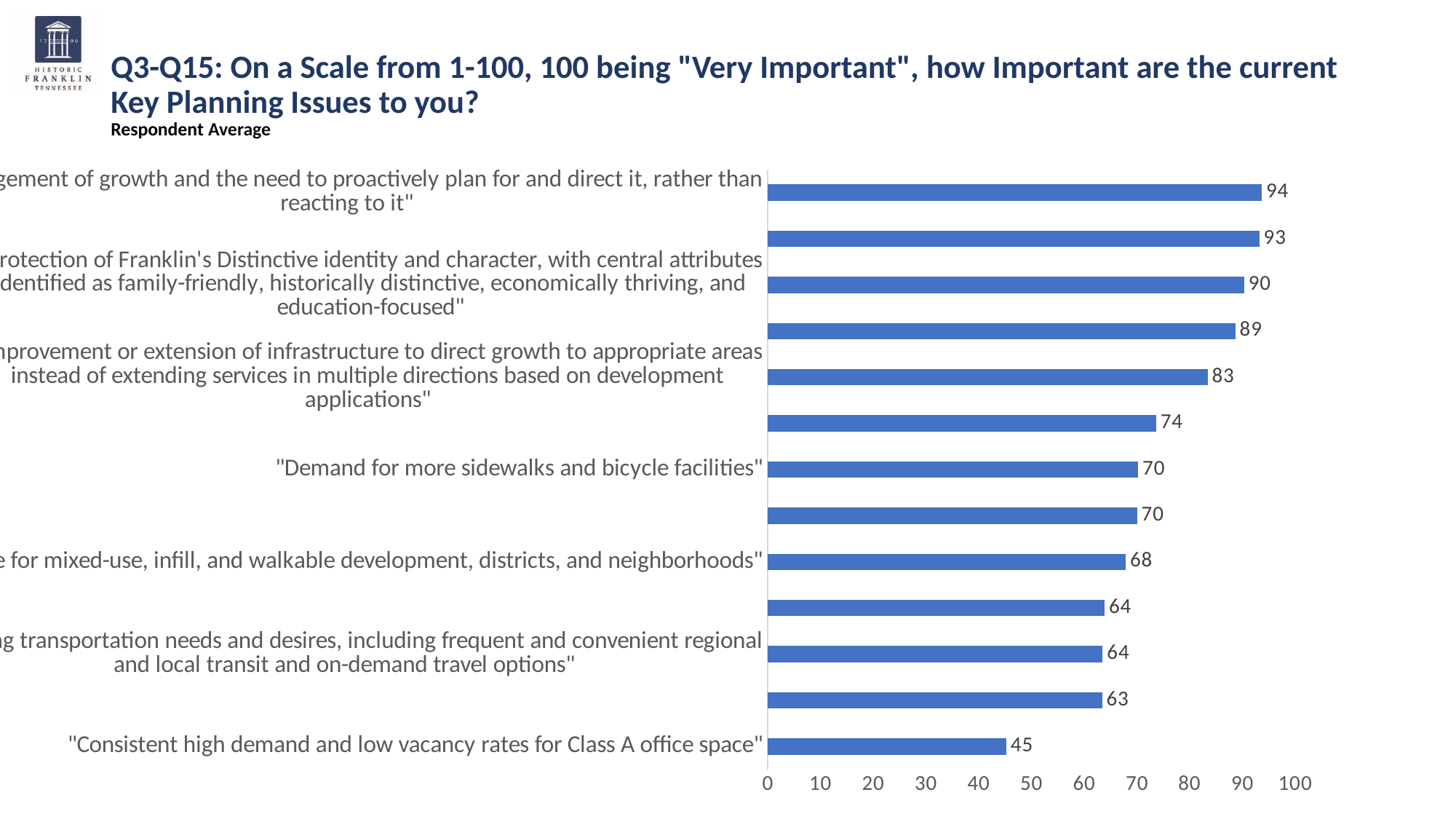
What is the respondent average for "Consistent high demand and low vacancy rates for Class A office space"? 45 What is the lowest value shown on the chart? 45 How many bars are plotted on the chart? 13 What is the highest value shown on the chart? 94 What is the respondent average for "Demand for more sidewalks and bicycle facilities"? 70 Which is larger: the value for "Demand for more sidewalks and bicycle facilities" or the value for "Consistent high demand and low vacancy rates for Class A office space"? "Demand for more sidewalks and bicycle facilities" What is the difference between the highest value (94) and the lowest value (45) on the chart? 49 What is the difference between the value for "Demand for more sidewalks and bicycle facilities" and the value for "Consistent high demand and low vacancy rates for Class A office space"? 25 Which category has the lowest respondent average? "Consistent high demand and low vacancy rates for Class A office space" How many bars on the chart have a value of 70? 2 What kind of chart is shown on the slide? Bar chart What is the maximum value shown on the horizontal axis? 100